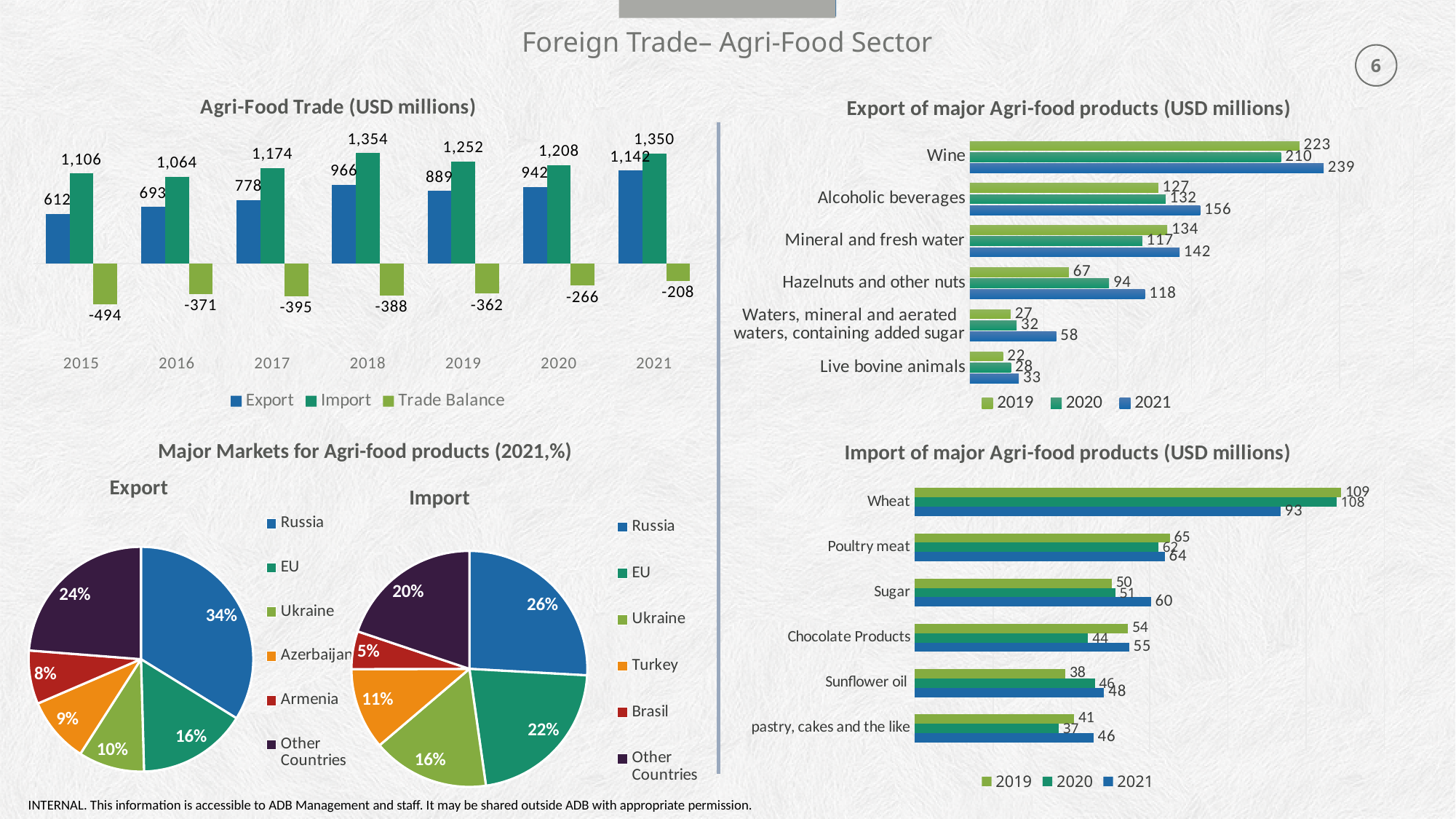
In the 'Agri-Food Trade (USD millions)' chart, does the Export value rise or fall from 2015 to 2018? rise In the 'Agri-Food Trade (USD millions)' chart, what is the difference between Import and Export in 2021? 208 In the 'Agri-Food Trade (USD millions)' chart, how many series does the legend list? 3 In the 'Export of major Agri-food products (USD millions)' chart, what is the 2021 value for Wine? 239 In the 'Major Markets for Agri-food products (2021,%)' Export pie chart, what share does Russia have? 34% In the 'Agri-Food Trade (USD millions)' chart, which year has the highest Import value? 2018 In the 'Import of major Agri-food products (USD millions)' chart, which is larger for Wheat: the 2019 value or the 2021 value? 2019 In the 'Export of major Agri-food products (USD millions)' chart, which product has the lowest 2019 value? Live bovine animals What kind of chart is used for the 'Major Markets for Agri-food products (2021,%)' Import breakdown? pie chart In the 'Agri-Food Trade (USD millions)' chart, what is the Export value for 2018? 966 In the 'Import of major Agri-food products (USD millions)' chart, what is the 2020 value for Chocolate Products? 44 In the 'Export of major Agri-food products (USD millions)' chart, how many product categories are shown? 6